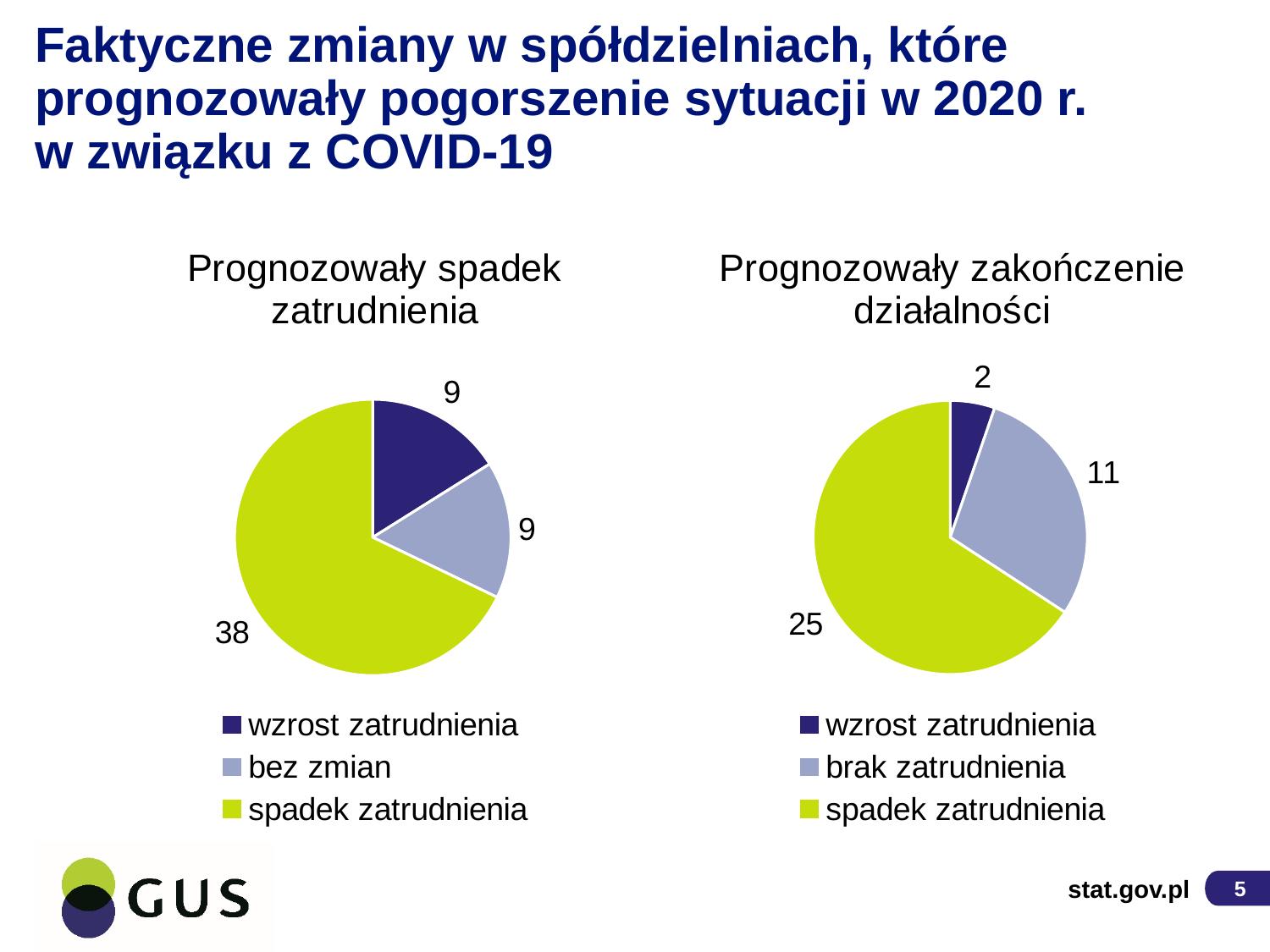
In the chart titled "Prognozowały spadek zatrudnienia", what is the difference between the values for "spadek zatrudnienia" and "wzrost zatrudnienia"? 29 What type of chart is used on this slide? pie chart In the chart titled "Prognozowały spadek zatrudnienia", what is the value for "spadek zatrudnienia"? 38 In the chart titled "Prognozowały spadek zatrudnienia", what is the total of all slices? 56 In the chart titled "Prognozowały zakończenie działalności", what is the value for "brak zatrudnienia"? 11 How many slices does the chart titled "Prognozowały spadek zatrudnienia" have? 3 In the chart titled "Prognozowały zakończenie działalności", what is the difference between the values for "spadek zatrudnienia" and "brak zatrudnienia"? 14 In the chart titled "Prognozowały zakończenie działalności", which category has the smallest slice? wzrost zatrudnienia In the chart titled "Prognozowały spadek zatrudnienia", what is the value for "bez zmian"? 9 In the chart titled "Prognozowały zakończenie działalności", what is the value for "wzrost zatrudnienia"? 2 In the chart titled "Prognozowały zakończenie działalności", which category has the largest slice? spadek zatrudnienia Which is larger: the value for "spadek zatrudnienia" in the left chart or the value for "spadek zatrudnienia" in the right chart? the left chart (38)